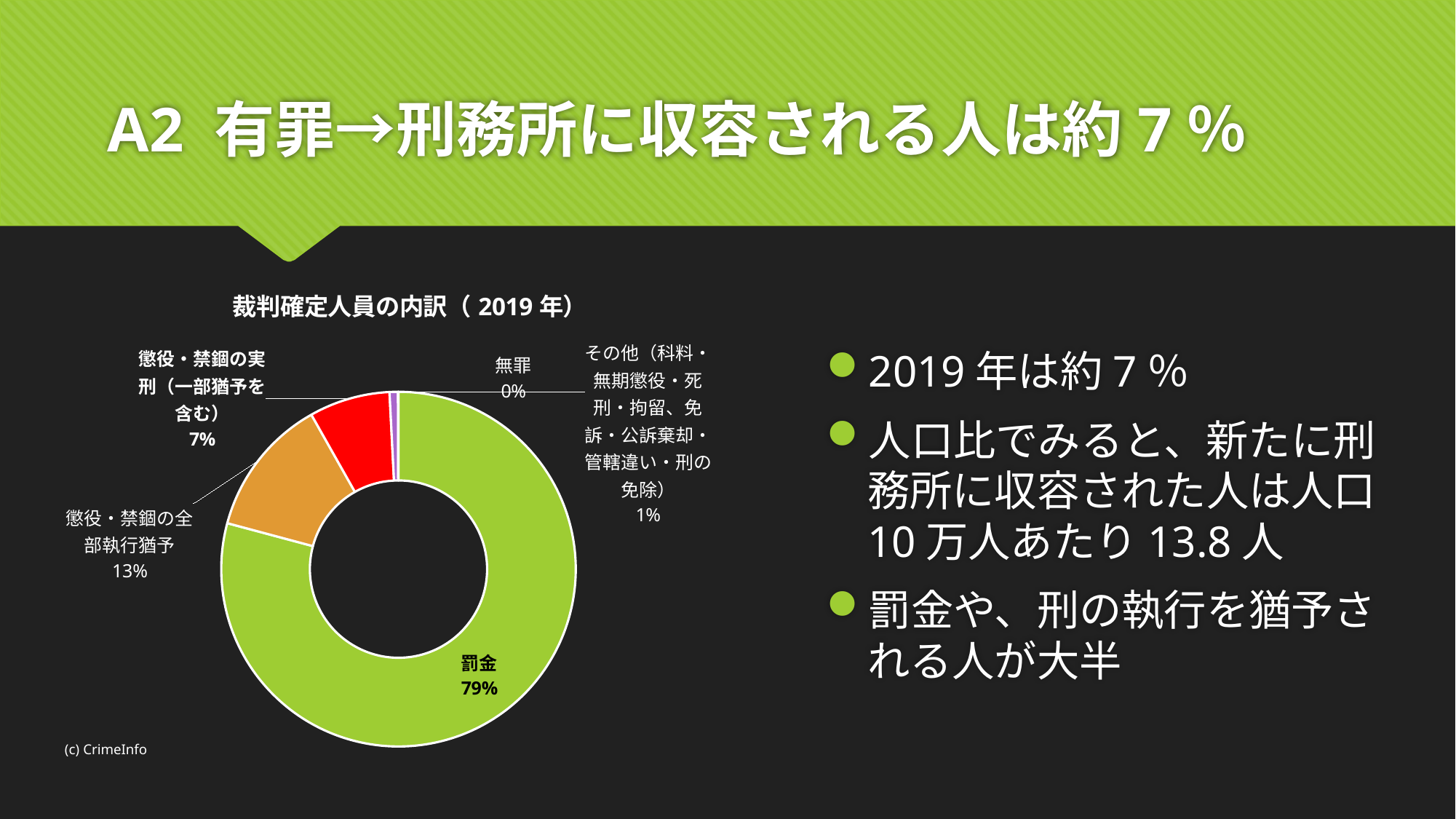
Which is larger, the share for 懲役・禁錮の全部執行猶予 or the share for 懲役・禁錮の実刑（一部猶予を含む）? 懲役・禁錮の全部執行猶予 What kind of chart is shown on the slide? Doughnut (pie) chart What share of the chart does the その他 category account for? 1% What is the difference in percentage points between 罰金 and 懲役・禁錮の全部執行猶予? 66 percentage points What share of the chart does 罰金 account for? 79% Which category has the largest share in the chart? 罰金 What share of the chart does 懲役・禁錮の全部執行猶予 account for? 13% What share of the chart does 懲役・禁錮の実刑（一部猶予を含む） account for? 7% What is the title of the chart on the slide? 裁判確定人員の内訳（2019年） Which category has the smallest share in the chart? 無罪 What share of the chart does 無罪 account for? 0% How many categories are shown in the chart? 5